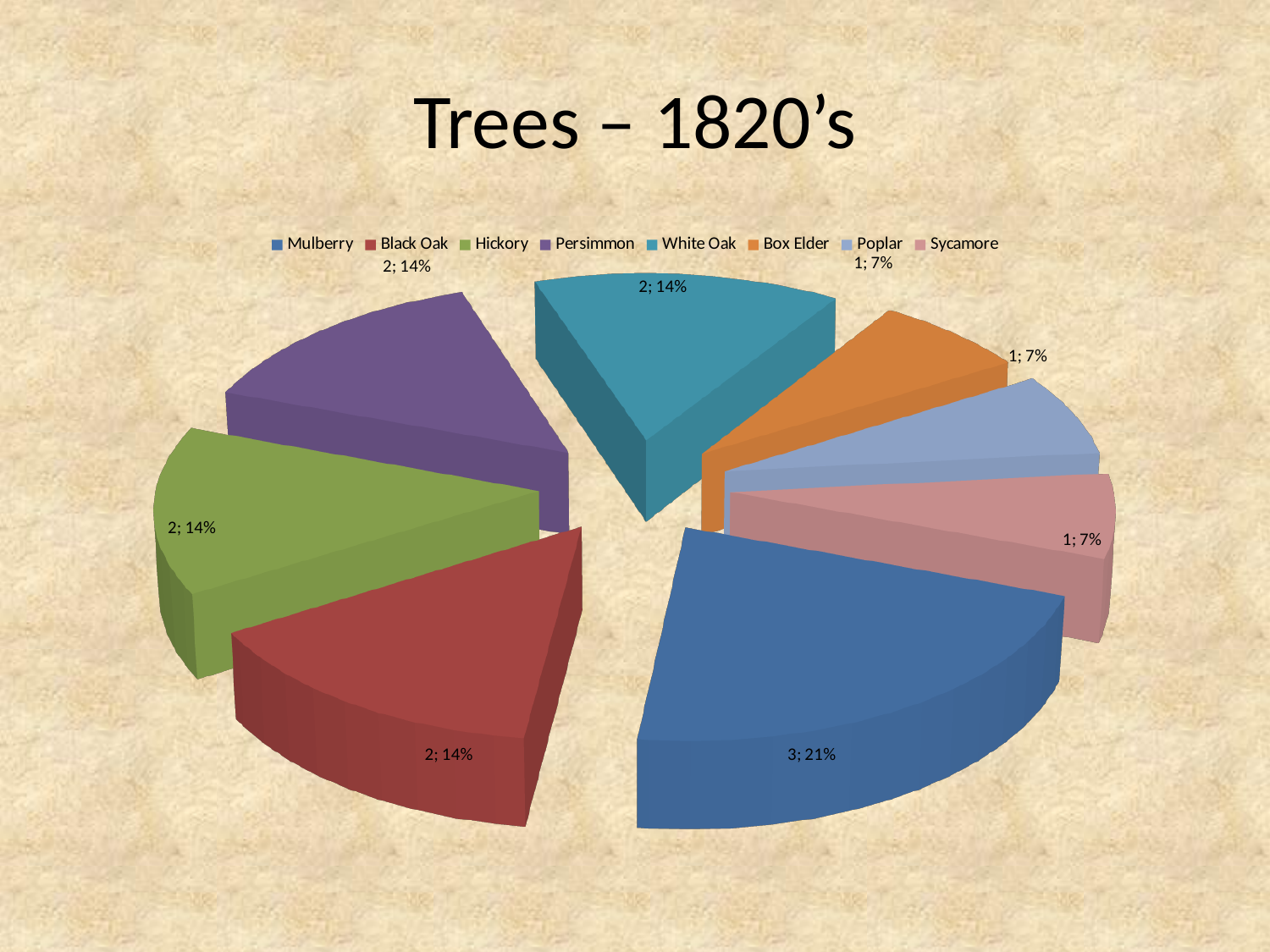
How many categories does the pie chart have? 8 What share of the pie does Mulberry have? 21% What is the difference between the value for Mulberry and the value for Poplar? 2 What is the value shown for Mulberry? 3 What is the value shown for Black Oak? 2 What is the smallest percentage shown on any slice? 7% What kind of chart is shown on the slide? pie chart What colour is the Persimmon slice? purple What share of the pie does Sycamore have? 7% Which category has the largest slice of the pie? Mulberry What is the title of the chart? Trees – 1820's Which is larger, the value for Mulberry or the value for Hickory? Mulberry